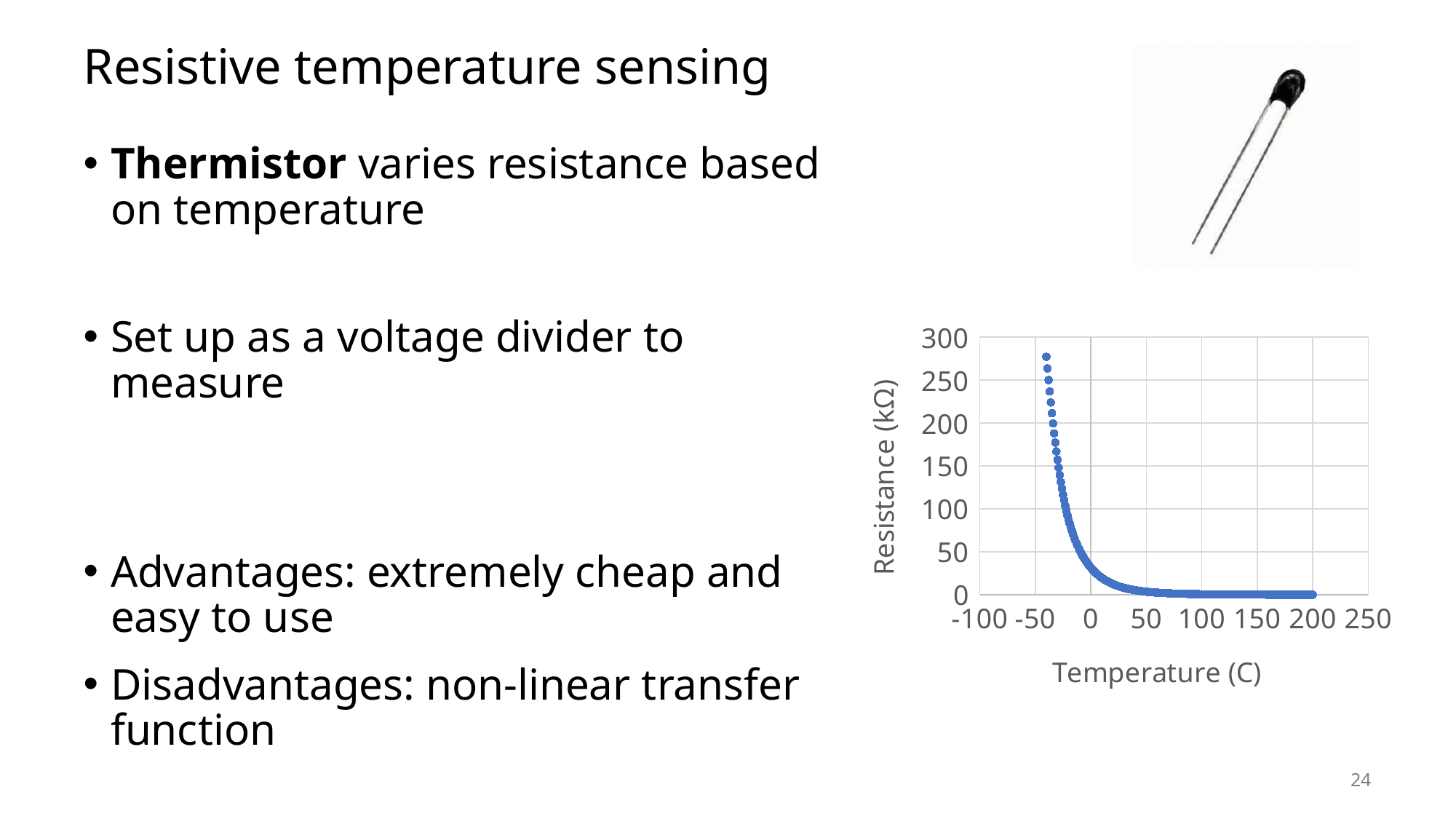
Is the highest plotted resistance value greater or less than 250 kΩ? greater What is the label of the y axis of the chart? Resistance (kΩ) What kind of chart is shown on the slide? scatter chart Is the resistance at a temperature of 0 C greater or less than 100 kΩ? less Is the resistance at a temperature of 100 C greater or less than 50 kΩ? less Which end of the temperature range has the higher resistance, the low-temperature end or the high-temperature end? low-temperature end What is the maximum value shown on the y axis of the chart? 300 Does resistance rise or fall as temperature increases along the x axis? fall What is the label of the x axis of the chart? Temperature (C)